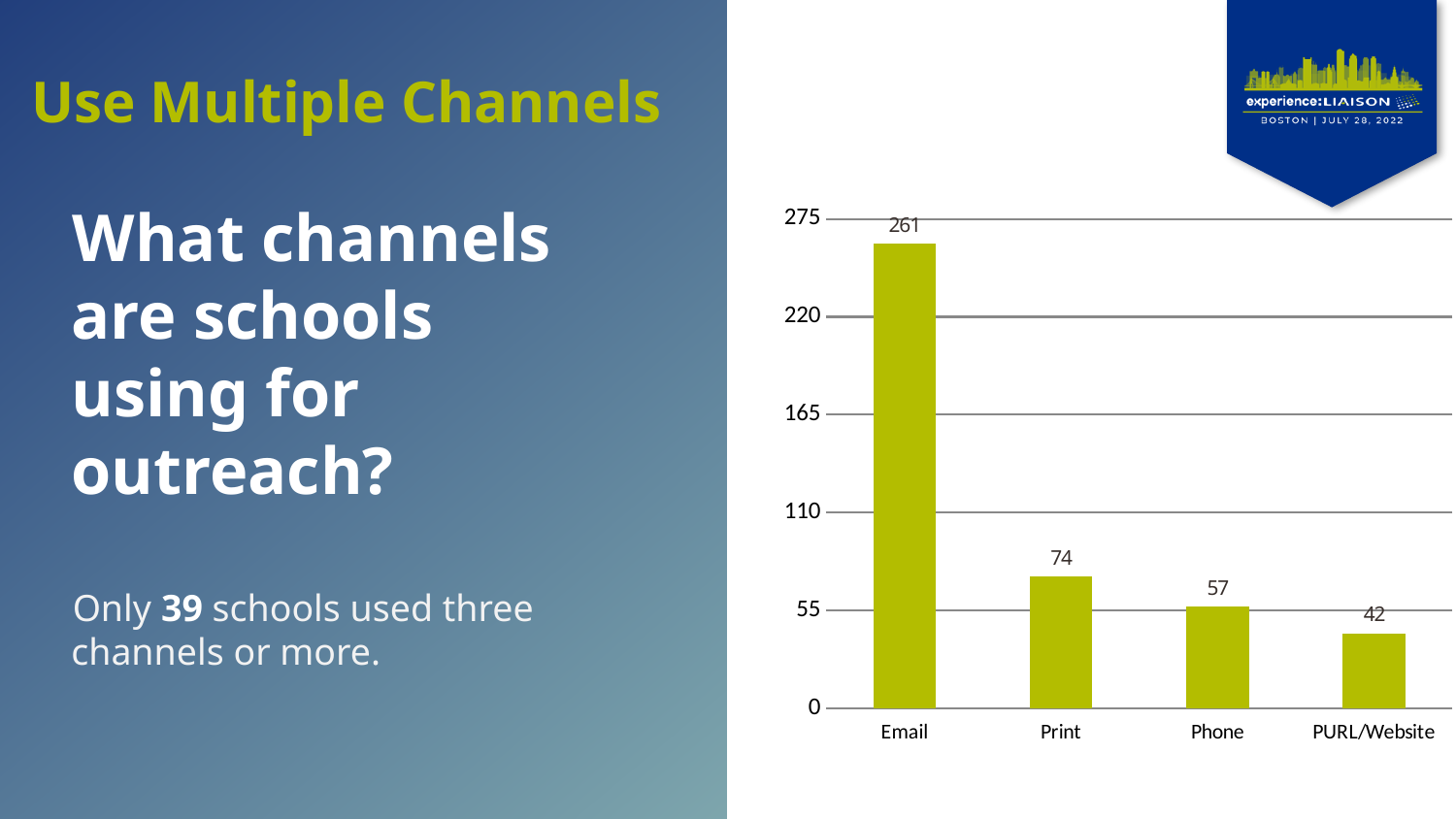
What is the value for Phone? 57 What is the value for PURL/Website? 42 What is the difference between the values for Phone and PURL/Website? 15 Which is larger, the value for Print or the value for Phone? Print What is the value for Print? 74 What kind of chart is shown on the slide? Bar chart What is the difference between the values for Email and Print? 187 What is the value for Email? 261 Do the values rise or fall from left to right across the chart? Fall How many channels are shown on the chart? 4 Which channel has the highest value? Email Which channel has the lowest value? PURL/Website